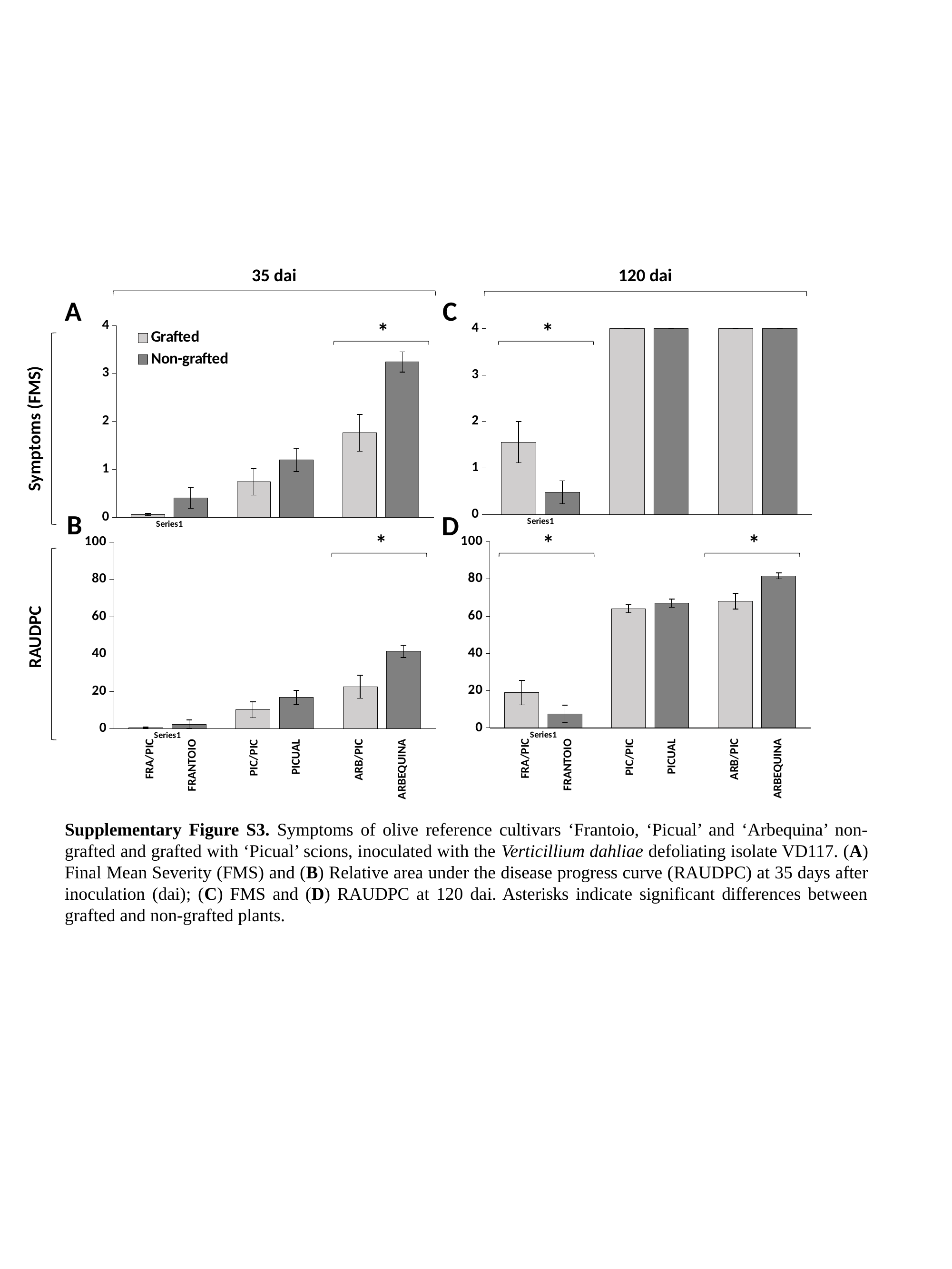
In chart B (RAUDPC at 35 dai), which category has the highest value? ARBEQUINA In chart C (FMS at 120 dai), is the value for FRANTOIO greater or less than 1? less In chart A (FMS at 35 dai), is the value for ARBEQUINA greater or less than 3? greater What kind of chart is chart A (Symptoms (FMS) at 35 dai)? bar chart In chart A (FMS at 35 dai), which category has the lowest value? FRA/PIC In chart B (RAUDPC at 35 dai), which is larger, the value for ARB/PIC or the value for ARBEQUINA? ARBEQUINA In chart C (FMS at 120 dai), what is the value for PIC/PIC? 4 In chart A (FMS at 35 dai), is the value for PIC/PIC greater or less than 1? less In chart A (FMS at 35 dai), which category has the highest value? ARBEQUINA In chart D (RAUDPC at 120 dai), which category has the lowest value? FRANTOIO How many series does the legend in chart A list? 2